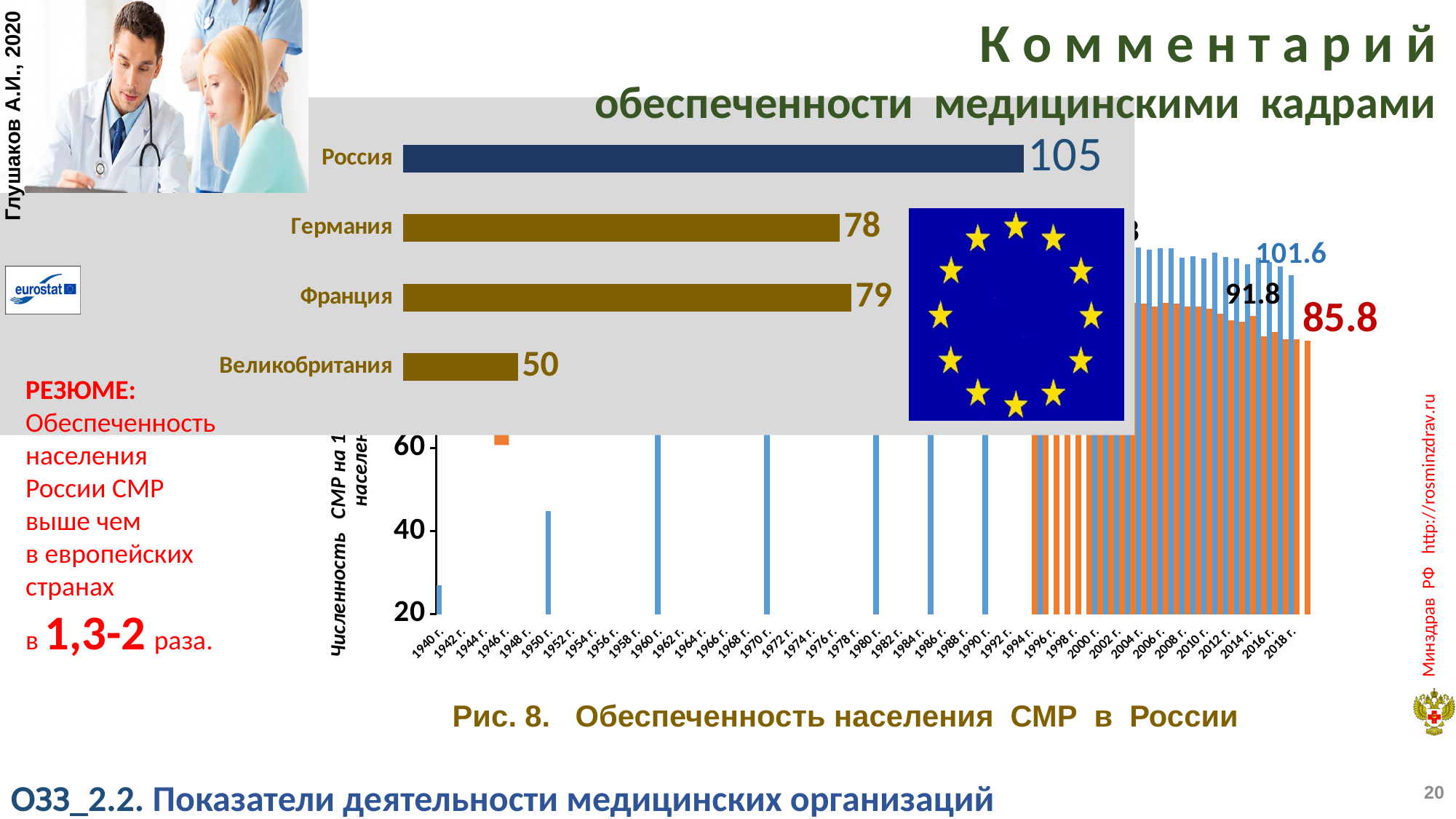
In the horizontal bar chart comparing countries, which has the larger value, Франция or Германия? Франция What kind of chart is the chart comparing Россия, Германия, Франция and Великобритания? bar chart In the horizontal bar chart comparing countries, which country has the lowest value? Великобритания In the horizontal bar chart comparing countries, which country has the highest value? Россия How many countries are shown in the horizontal bar chart comparing countries? 4 In the horizontal bar chart comparing countries at the top of the slide, what is the value for Россия? 105 In the horizontal bar chart comparing countries, what is the difference between the values for Россия and Германия? 27 In the horizontal bar chart comparing countries, what is the value for Великобритания? 50 In the chart 'Рис. 8. Обеспеченность населения СМР в России', is the value for 1950 г. greater or less than 60? less In the chart 'Рис. 8. Обеспеченность населения СМР в России', is the value for 1940 г. greater or less than 40? less In the chart 'Рис. 8. Обеспеченность населения СМР в России', what is the value shown by the red data label at the right end of the chart? 85.8 In the horizontal bar chart comparing countries, what is the value for Германия? 78